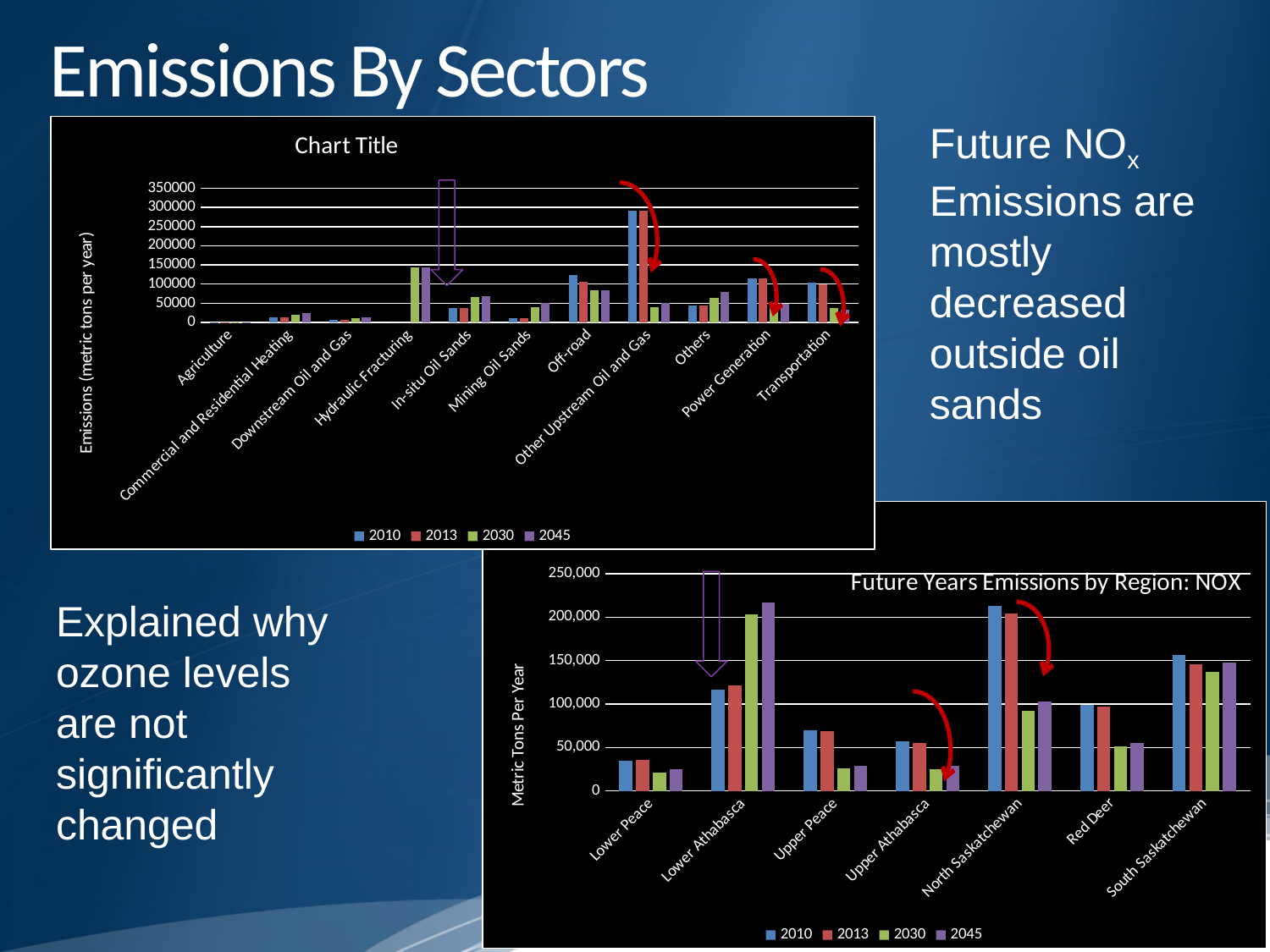
In the top chart titled 'Chart Title', is the 2010 value for In-situ Oil Sands greater or less than 50000? less In the chart 'Future Years Emissions by Region: NOX', which region has the lowest 2010 value? Lower Peace In the chart 'Future Years Emissions by Region: NOX', which region has the highest 2010 value? North Saskatchewan In the chart 'Future Years Emissions by Region: NOX', how many regions are shown on the x axis? 7 In the top chart titled 'Chart Title', how many sector categories are shown on the x axis? 11 How many charts are shown on the slide? 2 In the chart 'Future Years Emissions by Region: NOX', is the 2045 value for Lower Athabasca greater or less than 200,000? greater In the top chart titled 'Chart Title', how many series does the legend list? 4 In the top chart titled 'Chart Title', is the 2030 value for Hydraulic Fracturing greater or less than 100000? greater What kind of chart is 'Future Years Emissions by Region: NOX'? Bar chart In the top chart titled 'Chart Title', which sector has the highest 2010 value? Other Upstream Oil and Gas